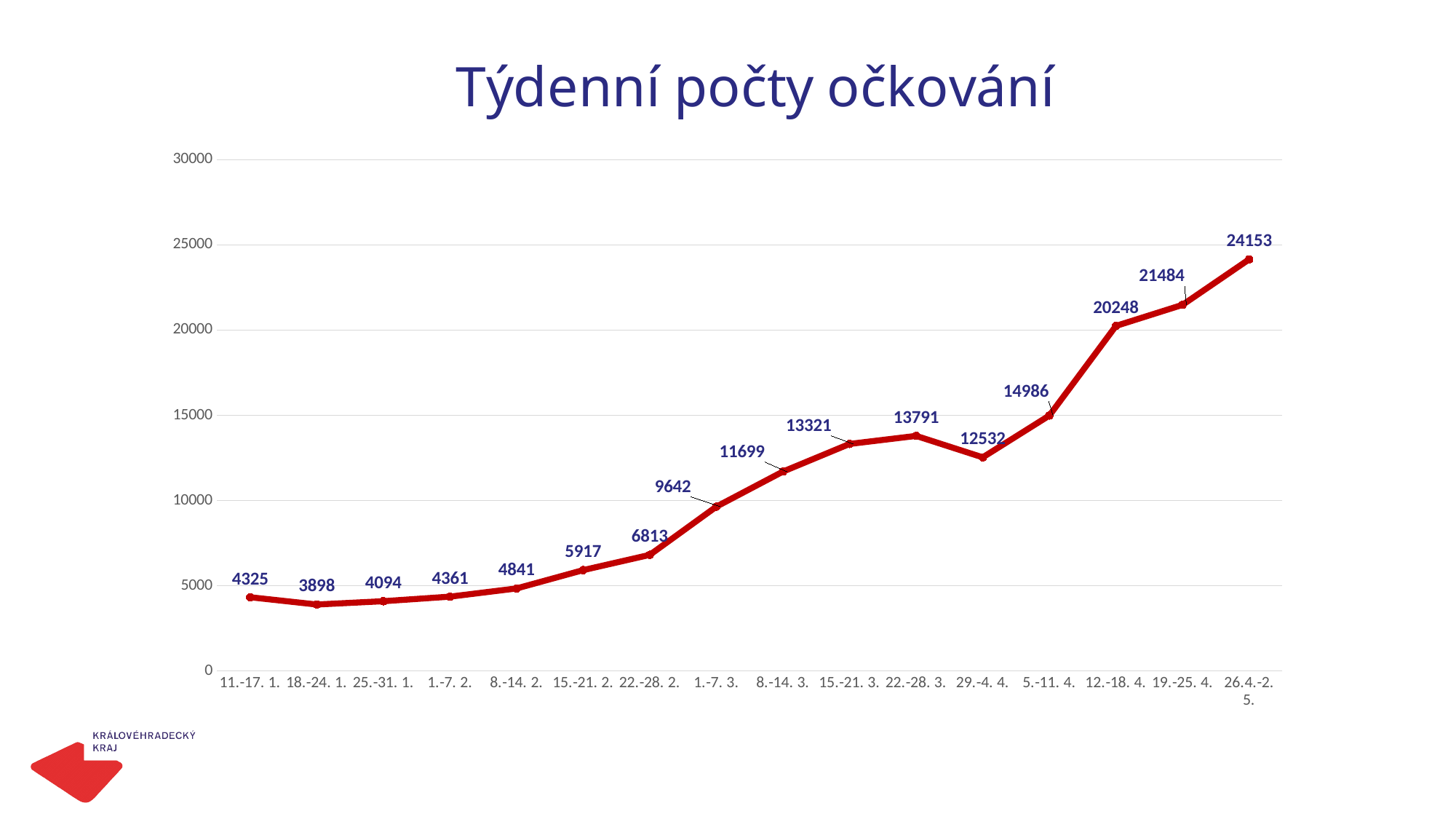
How many weeks are plotted on the chart? 16 Which week has the highest value? 26.4.-2. 5. Which week has the lowest value? 18.-24. 1. What is the difference between the values for 12.-18. 4. and 5.-11. 4.? 5262 Is the value for 19.-25. 4. greater or less than 20000? greater What is the title of the chart? Týdenní počty očkování What is the value for the week 1.-7. 3.? 9642 What is the value for the week 29.-4. 4.? 12532 What is the value for the week 11.-17. 1.? 4325 What is the value for the week 26.4.-2. 5.? 24153 What kind of chart is shown on the slide? line chart Which is larger, the value for 22.-28. 3. or the value for 29.-4. 4.? 22.-28. 3.